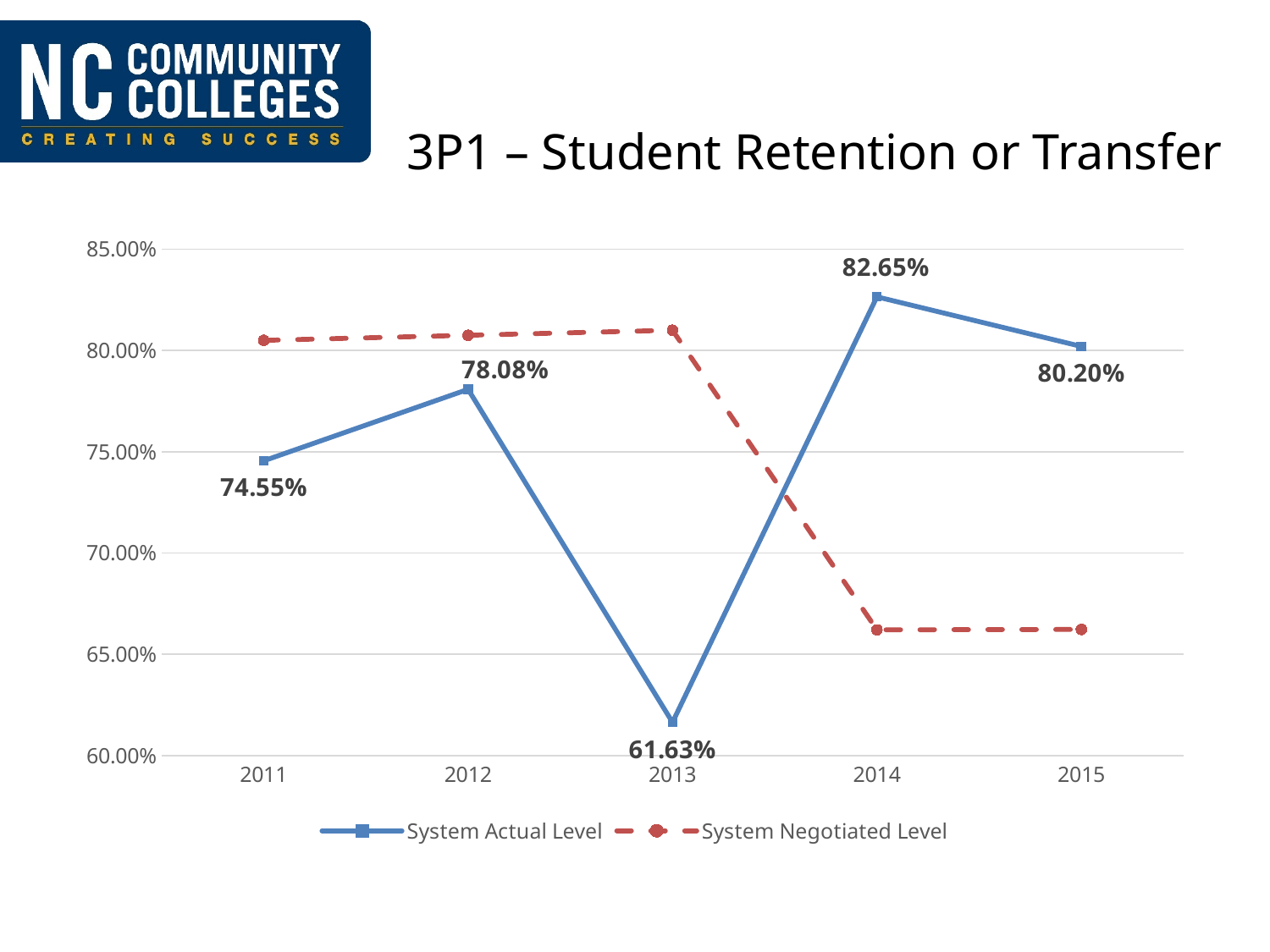
In which year is the System Actual Level highest? 2014 Is the System Negotiated Level for 2014 greater or less than 70.00%? less In which year is the System Actual Level lowest? 2013 Is the System Negotiated Level for 2012 greater or less than 80.00%? greater What is the System Actual Level for 2014? 82.65% What is the System Actual Level for 2013? 61.63% How many years are shown on the x axis? 5 Which is larger in 2013, the System Actual Level or the System Negotiated Level? System Negotiated Level How many series does the legend list? 2 What kind of chart is shown on the slide? Line chart What is the System Actual Level for 2011? 74.55% What is the difference between the System Actual Level in 2014 and in 2015? 2.45%